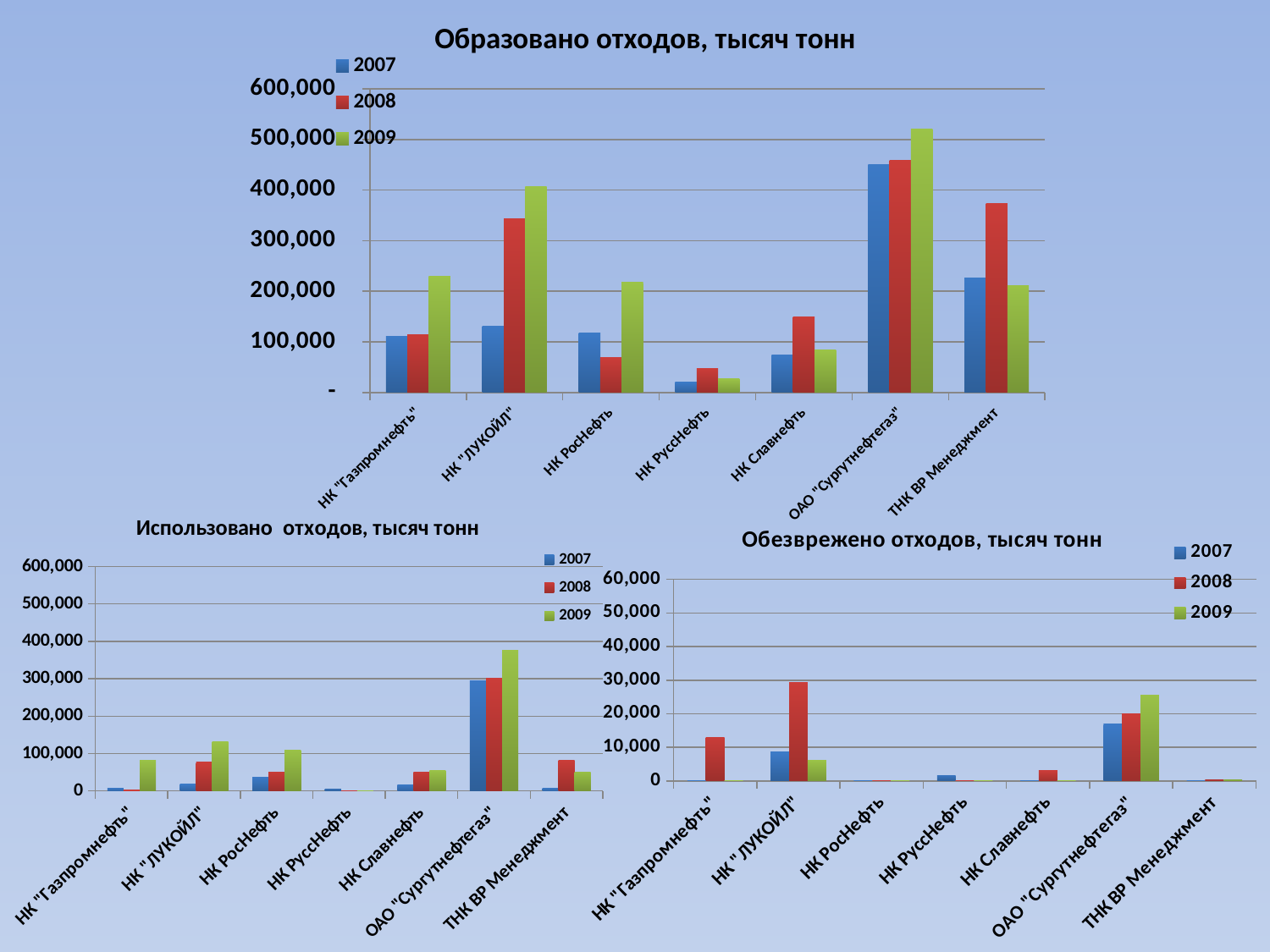
In the chart titled "Образовано отходов, тысяч тонн", how many companies are shown on the x axis? 7 In the chart titled "Использовано отходов, тысяч тонн", is the 2009 value for ОАО "Сургутнефтегаз" greater or less than 300,000? greater In the chart titled "Использовано отходов, тысяч тонн", which company has the highest 2009 value? ОАО "Сургутнефтегаз" How many charts are on the slide? 3 In the chart titled "Образовано отходов, тысяч тонн", is the 2009 value for ОАО "Сургутнефтегаз" greater or less than 500,000? greater In the chart titled "Образовано отходов, тысяч тонн", do the values for НК "ЛУКОЙЛ" rise or fall from 2007 to 2009? rise In the chart titled "Обезврежено отходов, тысяч тонн", which company has the highest 2008 value? НК "ЛУКОЙЛ" In the chart titled "Образовано отходов, тысяч тонн", how many series does the legend list? 3 In the chart titled "Образовано отходов, тысяч тонн", which company has the lowest 2007 value? НК РуссНефть What kind of chart is "Образовано отходов, тысяч тонн"? bar chart In the chart titled "Образовано отходов, тысяч тонн", which company has the highest 2009 value? ОАО "Сургутнефтегаз" In the chart titled "Обезврежено отходов, тысяч тонн", which is larger: the 2008 value for НК "ЛУКОЙЛ" or the 2008 value for ОАО "Сургутнефтегаз"? НК "ЛУКОЙЛ"